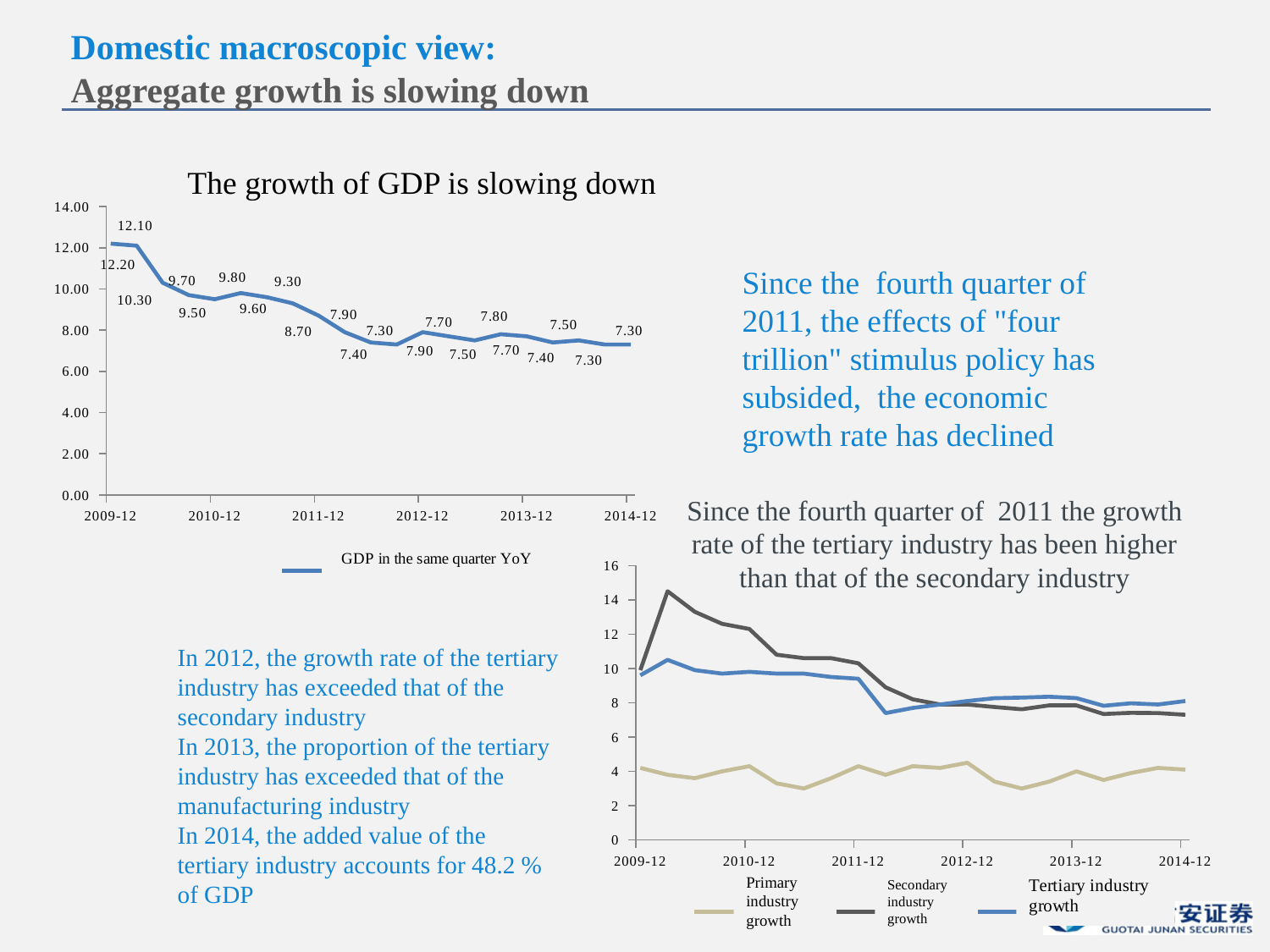
In the chart 'The growth of GDP is slowing down', how many labels are on the x axis? 6 In the chart 'The growth of GDP is slowing down', what is the value at 2014-12? 7.30 In the chart 'The growth of GDP is slowing down', what is the difference between the first value (12.20) and the last value (7.30)? 4.90 In the chart 'The growth of GDP is slowing down', what is the highest value shown? 12.20 In the chart 'The growth of GDP is slowing down', what is the lowest value shown? 7.30 What is the legend entry of the chart 'The growth of GDP is slowing down'? GDP in the same quarter YoY In the bottom-right chart, at 2010-12, which is larger: Secondary industry growth or Tertiary industry growth? Secondary industry growth In the bottom-right chart, is the value for Secondary industry growth at 2010-12 greater or less than 10? greater In the chart 'The growth of GDP is slowing down', do the values rise or fall from 2009-12 to 2014-12? fall In the bottom-right chart, is the value for Primary industry growth at 2009-12 greater or less than 6? less What kind of chart is 'The growth of GDP is slowing down'? line chart How many series does the legend of the bottom-right chart list? 3